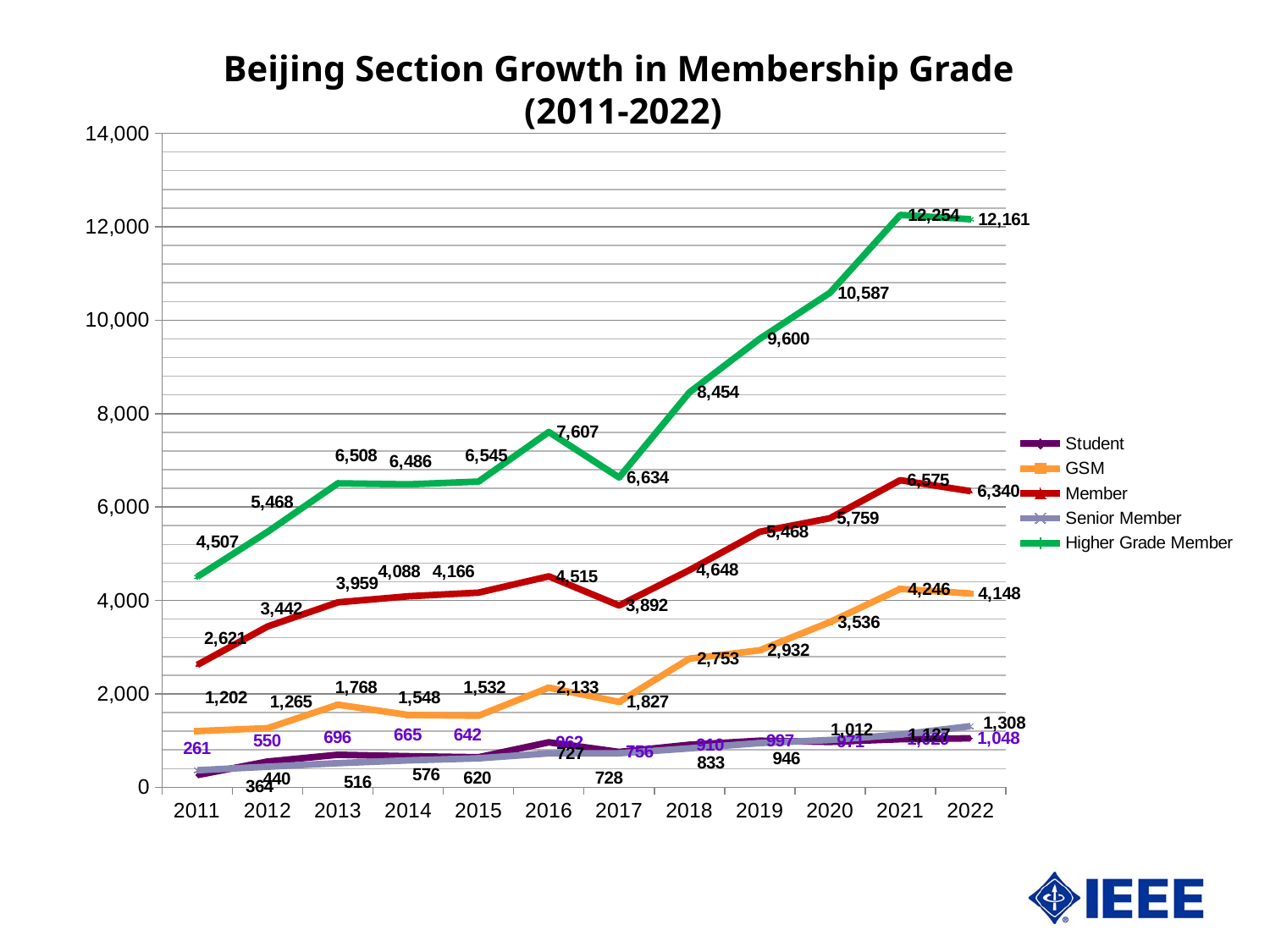
What is the value for Member in 2017? 3,892 What is the title of the chart? Beijing Section Growth in Membership Grade (2011-2022) How many years are plotted along the x axis? 12 What type of chart is shown on the slide? line chart How many series does the legend list? 5 What is the difference between the Higher Grade Member values in 2021 and 2022? 93 In which year is the Member value lowest? 2011 What is the value for Higher Grade Member in 2021? 12,254 Which is larger, the GSM value in 2016 or the GSM value in 2017? 2016 What is the value for Senior Member in 2022? 1,308 In which year is the Higher Grade Member value highest? 2021 What is the value for GSM in 2022? 4,148